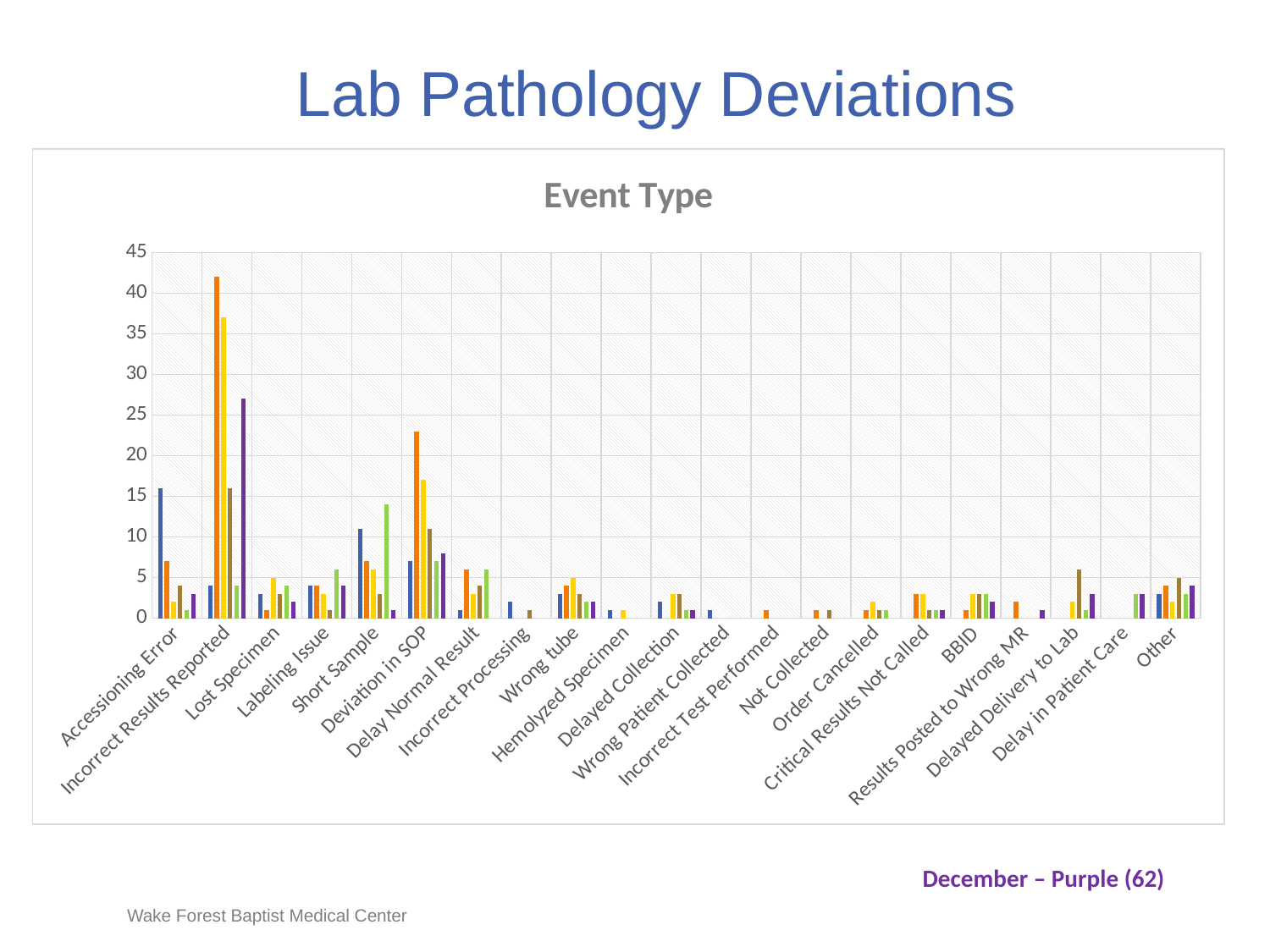
Is the tallest bar for Incorrect Results Reported greater or less than 40? greater Which has a taller green bar: Short Sample or Labeling Issue? Short Sample According to the note below the chart, which month do the purple bars represent? December Is the purple bar for Incorrect Results Reported greater or less than 25? greater Is the blue bar for Accessioning Error greater or less than 10? greater Which has a taller maximum bar: Incorrect Results Reported or Deviation in SOP? Incorrect Results Reported What is the title of the chart? Event Type Which event type has the tallest bar in the chart? Incorrect Results Reported How many event type categories are shown along the x axis? 21 What type of chart is shown on the slide? bar chart